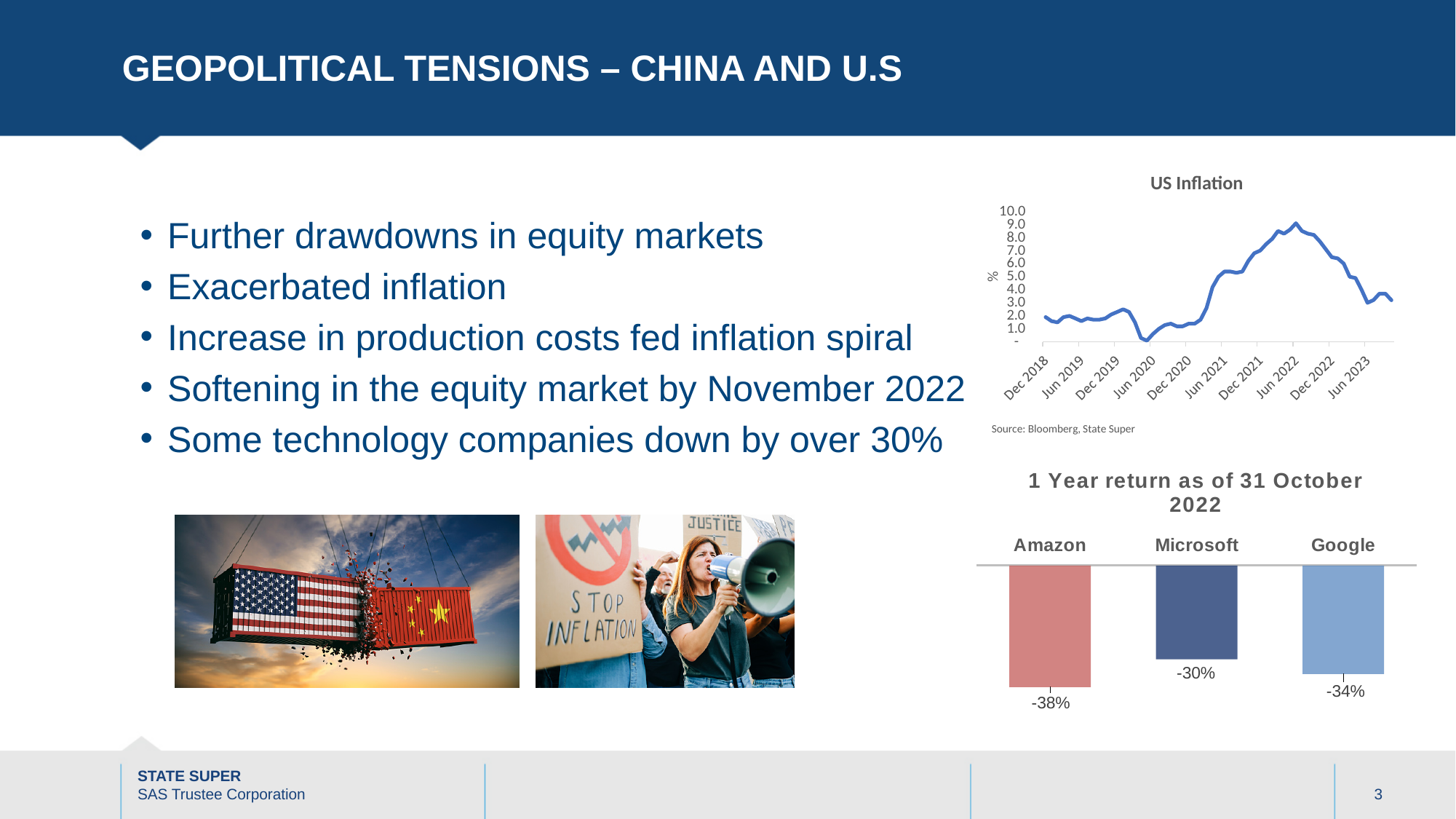
In the '1 Year return as of 31 October 2022' chart, what is the value for Microsoft? -30% In the '1 Year return as of 31 October 2022' chart, which company has the lowest 1 year return? Amazon How many companies are shown in the '1 Year return as of 31 October 2022' chart? 3 What kind of chart is the '1 Year return as of 31 October 2022' chart? Bar chart In the '1 Year return as of 31 October 2022' chart, which is larger, the return for Google or the return for Amazon? Google In the 'US Inflation' chart, is the value at Jun 2022 greater or less than 8.0? greater In the '1 Year return as of 31 October 2022' chart, which company has the highest 1 year return? Microsoft In the '1 Year return as of 31 October 2022' chart, what is the difference between the returns of Amazon and Microsoft? 8 percentage points In the 'US Inflation' chart, is the value at Dec 2018 greater or less than 3.0? less In the '1 Year return as of 31 October 2022' chart, what is the value for Google? -34% What kind of chart is the 'US Inflation' chart? Line chart In the '1 Year return as of 31 October 2022' chart, what is the value for Amazon? -38%